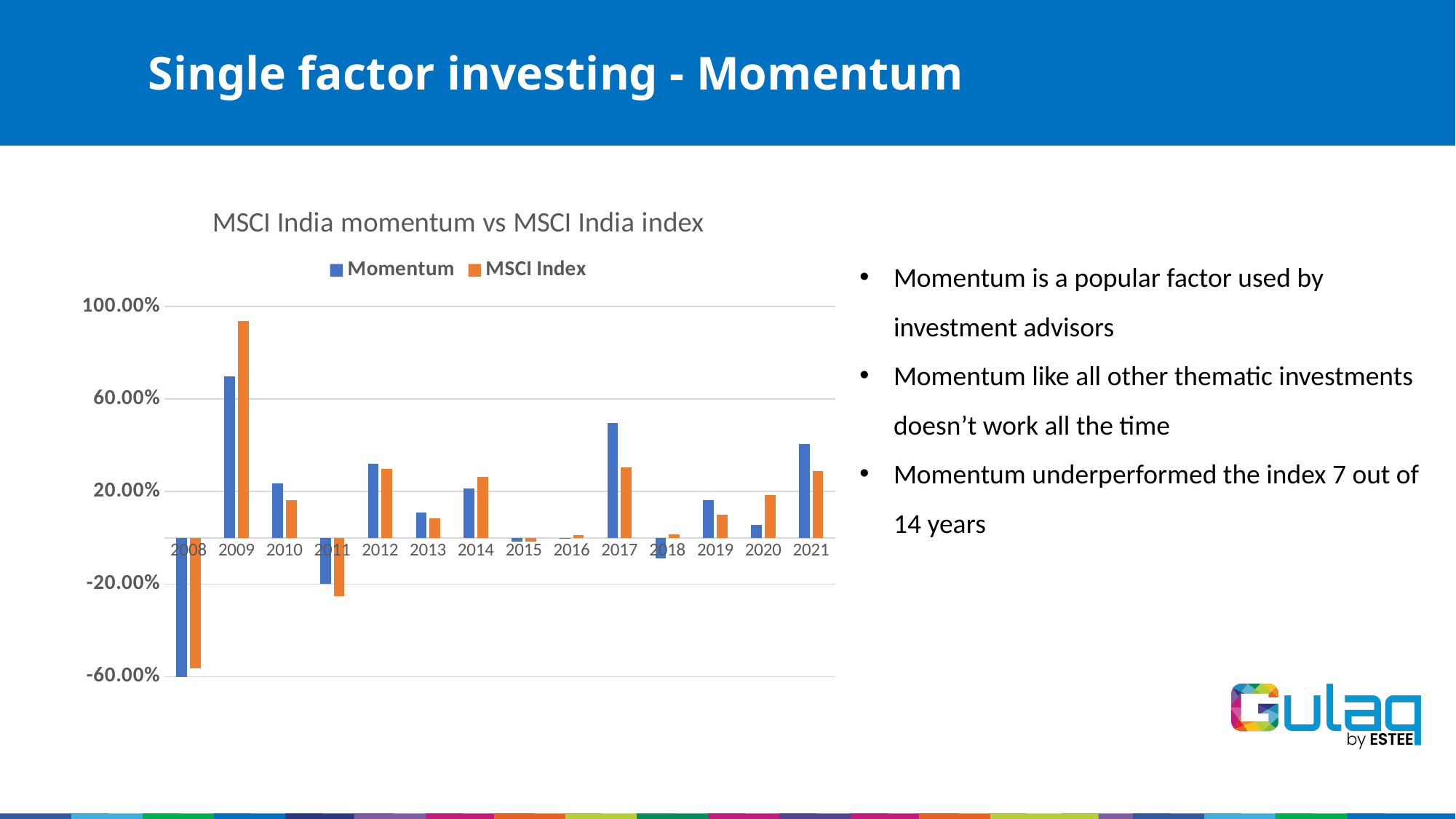
In 2017, which series has the larger value, Momentum or MSCI Index? Momentum Is the Momentum value for 2017 greater or less than 20.00%? greater In which year is the MSCI Index series lowest? 2008 How many years are shown on the x axis of the chart? 14 In which year is the MSCI Index series highest? 2009 In which year is the Momentum series highest? 2009 Is the MSCI Index value for 2009 greater or less than 60.00%? greater In which year is the Momentum series lowest? 2008 In 2009, which series has the larger value, Momentum or MSCI Index? MSCI Index What is the title of the chart? MSCI India momentum vs MSCI India index How many series does the legend of the chart list? 2 What kind of chart is shown on the slide? Bar chart